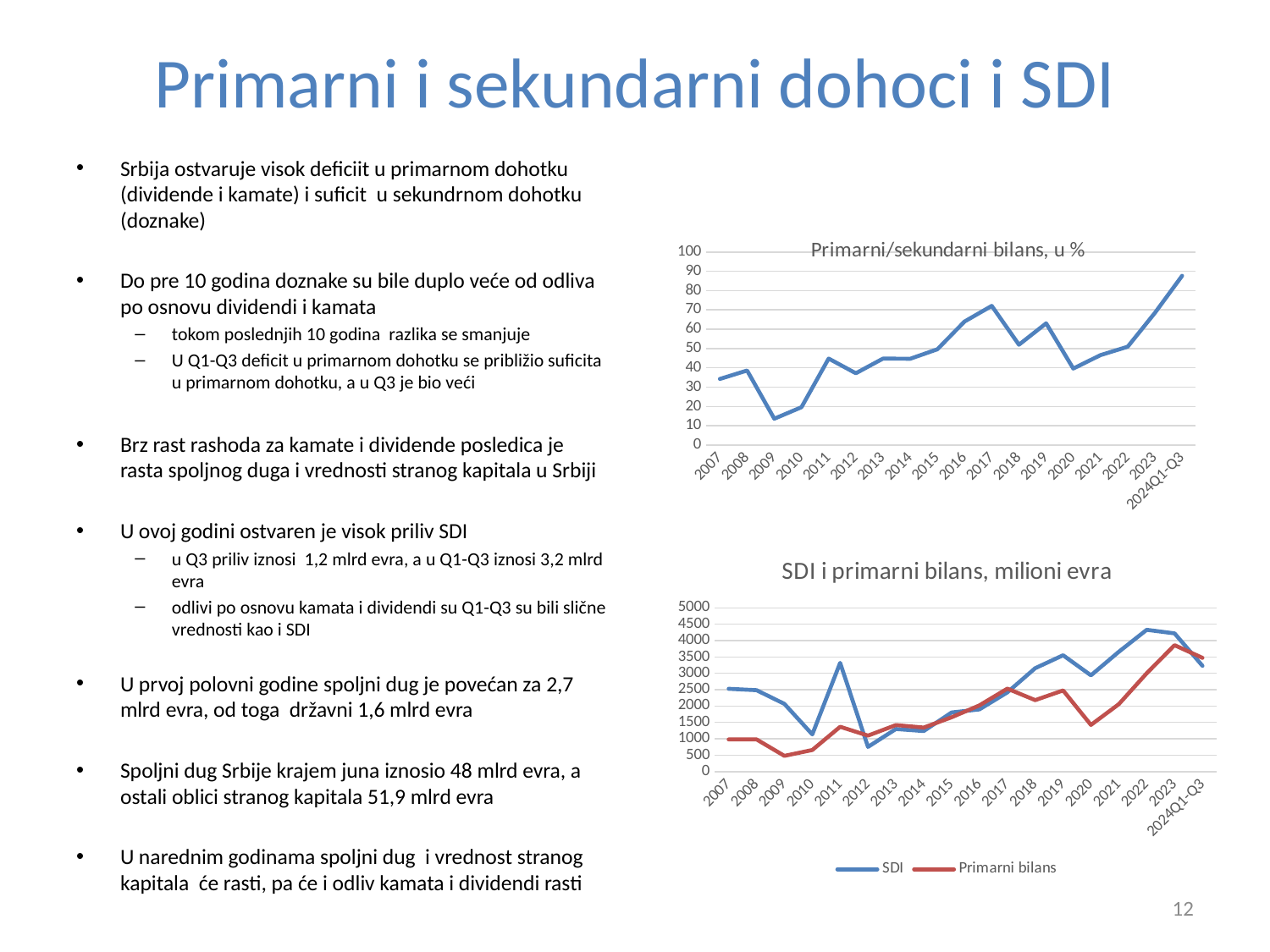
In the chart "SDI i primarni bilans, milioni evra", which category has the lowest value for SDI? 2012 In the chart "SDI i primarni bilans, milioni evra", is the SDI value for 2022 greater or less than 4000? greater What kind of chart is the chart titled "Primarni/sekundarni bilans, u %"? line chart In the chart "Primarni/sekundarni bilans, u %", which category has the lowest value? 2009 In the chart "SDI i primarni bilans, milioni evra", which is larger in 2011, SDI or Primarni bilans? SDI In the chart "SDI i primarni bilans, milioni evra", which series is drawn in red? Primarni bilans How many series does the legend of the chart "SDI i primarni bilans, milioni evra" list? 2 How many categories are shown on the x axis of the chart "Primarni/sekundarni bilans, u %"? 18 In the chart "Primarni/sekundarni bilans, u %", which category has the highest value? 2024Q1-Q3 In the chart "Primarni/sekundarni bilans, u %", is the value for 2024Q1-Q3 greater or less than 80? greater In the chart "Primarni/sekundarni bilans, u %", is the value for 2009 greater or less than 20? less In the chart "SDI i primarni bilans, milioni evra", which category has the lowest value for Primarni bilans? 2009